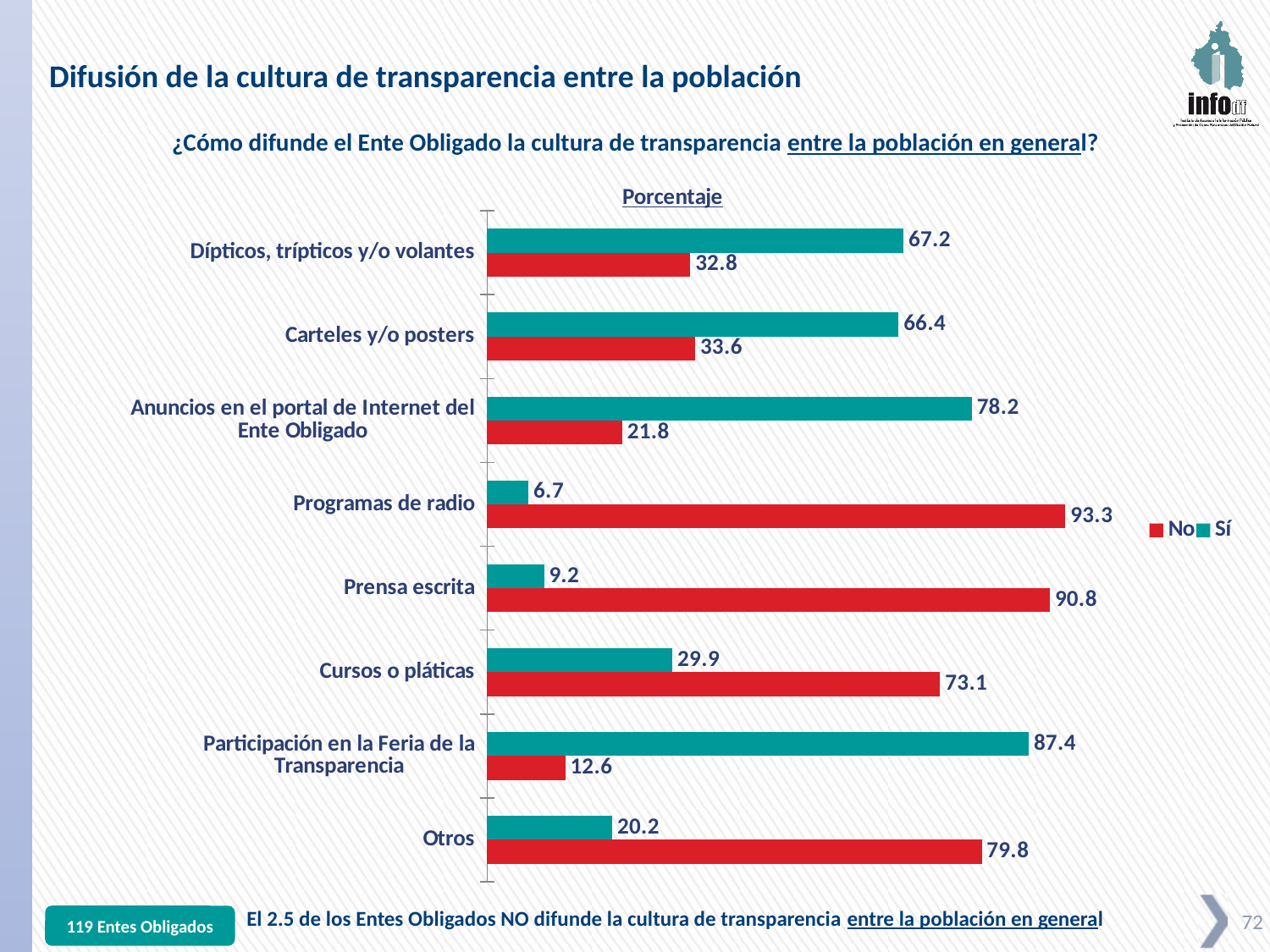
Which is larger for 'Cursos o pláticas', the 'Sí' value or the 'No' value? No What kind of chart is shown on the slide? Bar chart How many series does the legend list? 2 What is the 'Sí' value for 'Participación en la Feria de la Transparencia'? 87.4 What is the 'No' value for 'Otros'? 79.8 How many categories are shown in the chart? 8 What is the 'No' value for 'Programas de radio'? 93.3 Which colour represents the 'Sí' series in the chart? Teal Which category has the highest 'No' value? Programas de radio What is the difference between the 'Sí' and 'No' values for 'Dípticos, trípticos y/o volantes'? 34.4 What is the 'Sí' value for 'Anuncios en el portal de Internet del Ente Obligado'? 78.2 Which category has the lowest 'Sí' value? Programas de radio